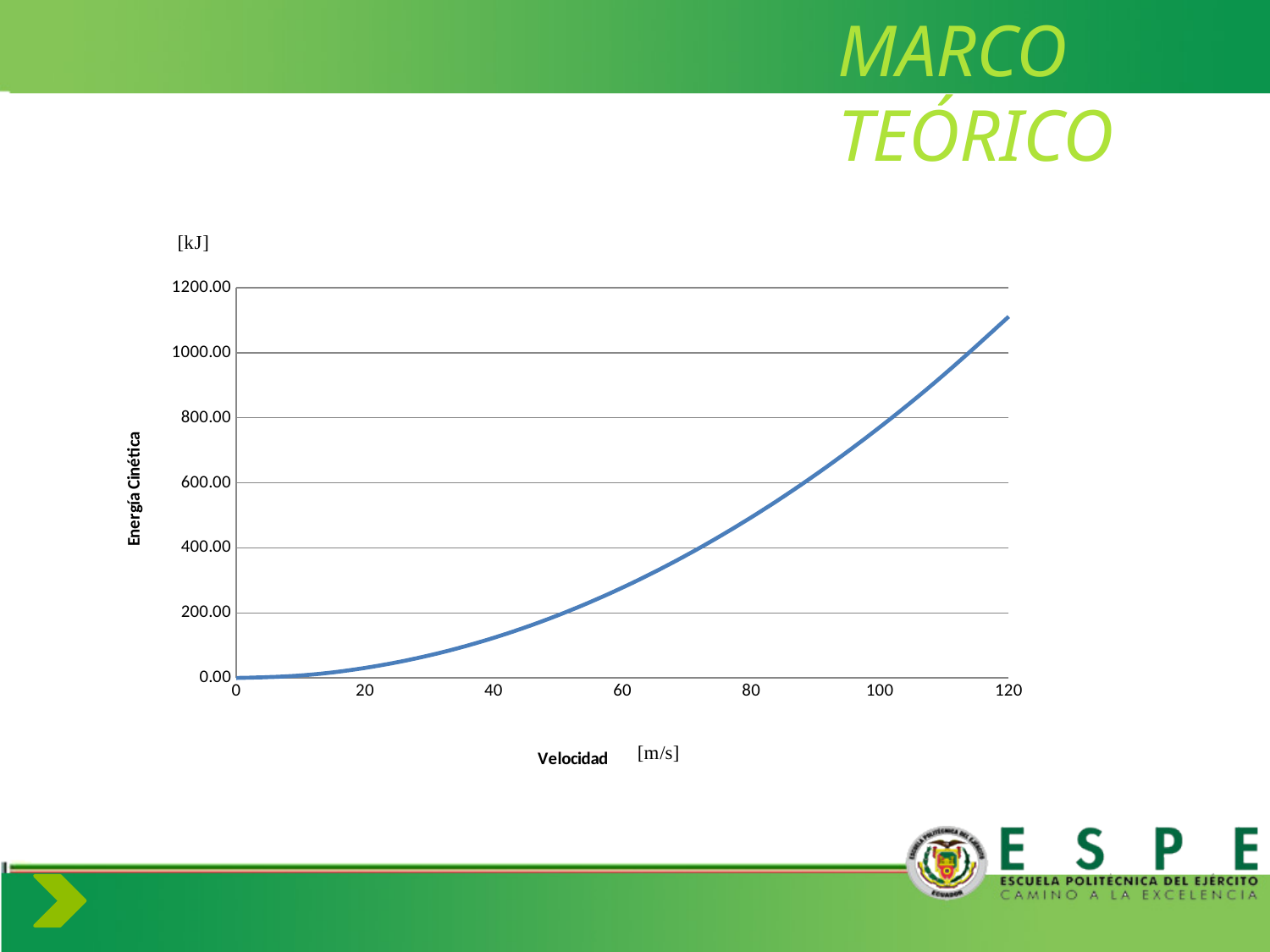
Is the value of Energía Cinética at a velocity of 40 m/s greater or less than 200? less What is the highest value shown on the y axis? 1200.00 Does the kinetic energy (Energía Cinética) rise or fall as velocity increases along the x axis? rises Is the value of Energía Cinética at a velocity of 120 m/s greater or less than 1000? greater What kind of chart is shown on the slide? line chart Is the value of Energía Cinética at a velocity of 60 m/s greater or less than 400? less Which velocity has the higher kinetic energy, 20 m/s or 100 m/s? 100 m/s What is the label of the x axis? Velocidad What unit is shown for the y axis (Energía Cinética)? [kJ] What is the value of Energía Cinética at a velocity of 0 m/s? 0.00